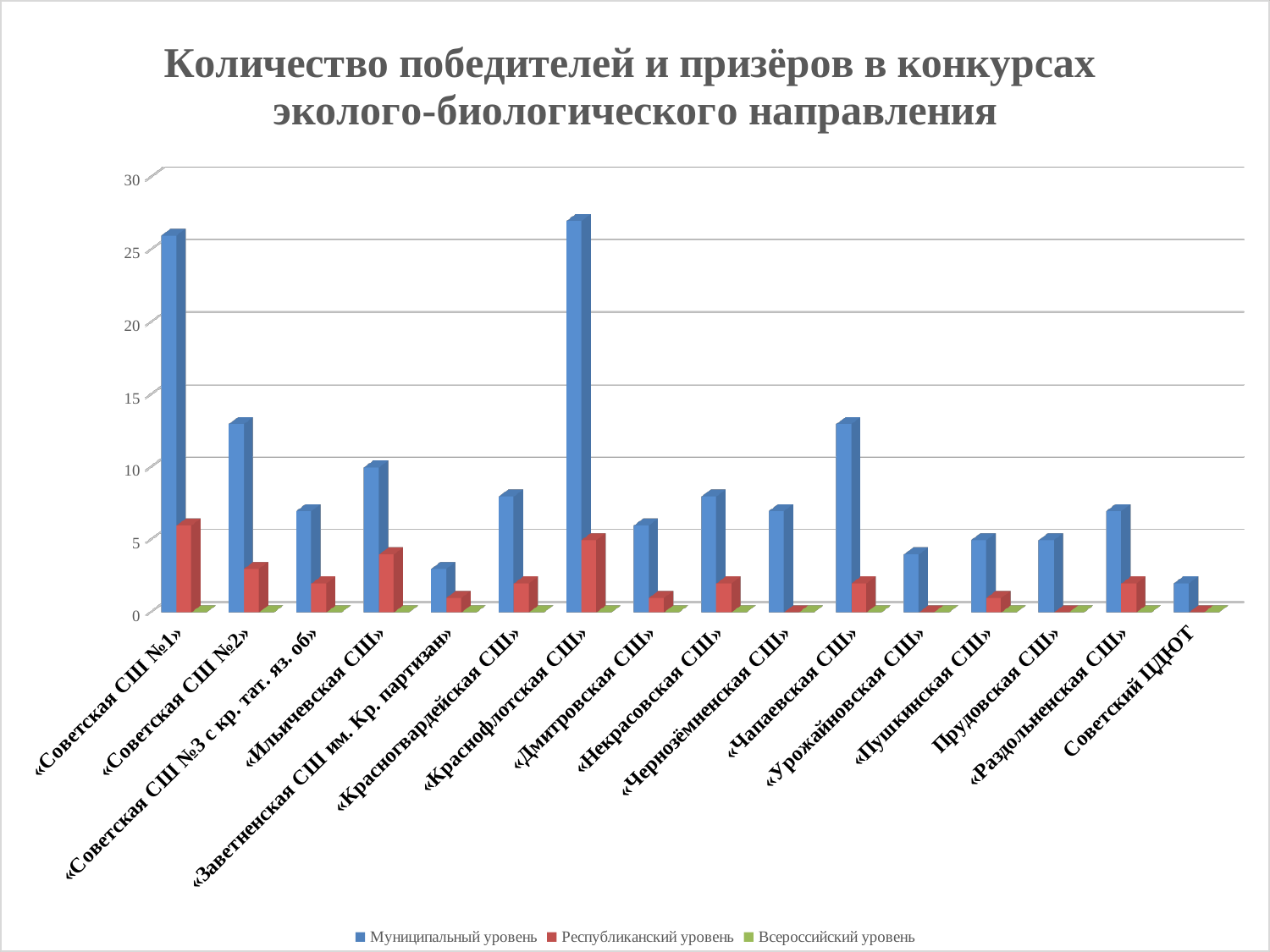
How many schools (categories) are shown on the x axis? 16 Which has the larger value for Муниципальный уровень: «Некрасовская СШ» or «Пушкинская СШ»? «Некрасовская СШ» Is the value for Муниципальный уровень at «Заветненская СШ им. Кр. партизан» greater or less than 5? less What is the title of the chart? Количество победителей и призёров в конкурсах эколого-биологического направления How many series does the legend list? 3 Is the value for Муниципальный уровень at «Краснофлотская СШ» greater or less than 25? greater Which has the larger value for Муниципальный уровень: «Советская СШ №2» or «Дмитровская СШ»? «Советская СШ №2» Is the value for Муниципальный уровень at «Чапаевская СШ» greater or less than 10? greater Which series is shown in blue according to the legend? Муниципальный уровень Which school has the lowest value for Муниципальный уровень? Советский ЦДЮТ What kind of chart is shown on the slide? bar chart